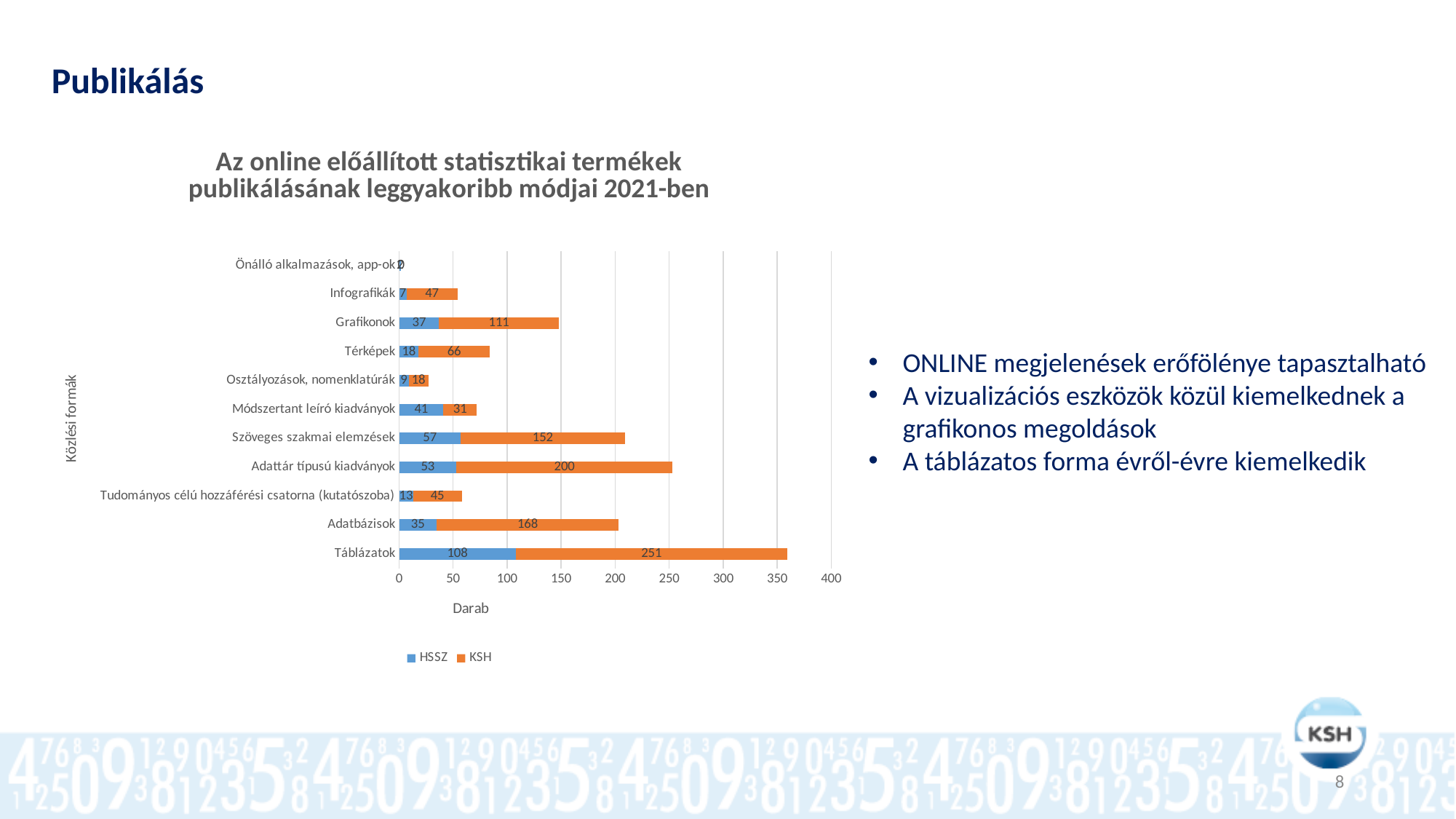
What is the HSSZ value for Grafikonok? 37 What type of chart is shown on the slide? Bar chart Which category has the highest KSH value? Táblázatok What is the KSH value for Táblázatok? 251 What is the KSH value for Adattár típusú kiadványok? 200 Which is larger for Módszertant leíró kiadványok, the HSSZ value or the KSH value? HSSZ What is the label of the horizontal axis of the chart? Darab How many categories are shown on the vertical axis of the chart? 11 Which category has the highest HSSZ value? Táblázatok How many series does the legend list? 2 What is the total of the stacked bar for Adatbázisok? 203 What is the difference between the KSH and HSSZ values for Szöveges szakmai elemzések? 95